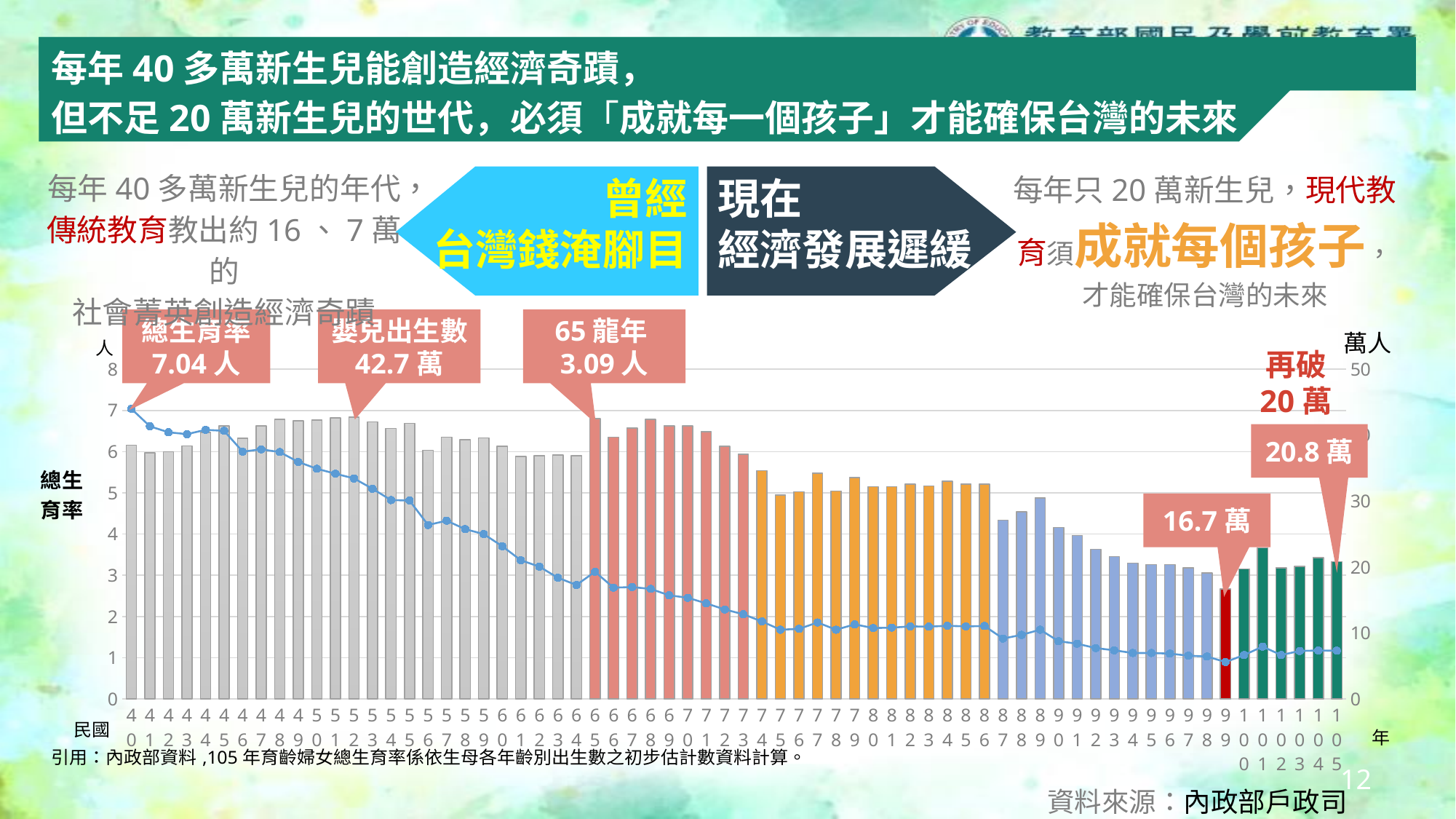
What is the 嬰兒出生數 value shown in the callout at the peak of the grey bars? 42.7 萬 What is the number of births shown in the callout for 民國 105? 20.8 萬 What is the 總生育率 value shown in the callout for 民國 40? 7.04 人 What unit is shown at the top of the right-hand axis? 萬人 What kind of chart is shown on the slide? bar chart with a line What is the difference between the births in 民國 105 (20.8 萬) and 民國 99 (16.7 萬)? 4.1 萬 What is the number of births shown in the callout for the red bar (民國 99)? 16.7 萬 What is the difference between the 總生育率 in 民國 40 (7.04 人) and in 65 龍年 (3.09 人)? 3.95 人 What is the 總生育率 value shown in the callout for 65 龍年? 3.09 人 Does the 總生育率 line generally rise or fall from 民國 40 to 民國 105? fall Which year has the highest 總生育率 on the line, 民國 40 or 65? 民國 40 Is the 總生育率 value for 民國 105 greater or less than 2? less